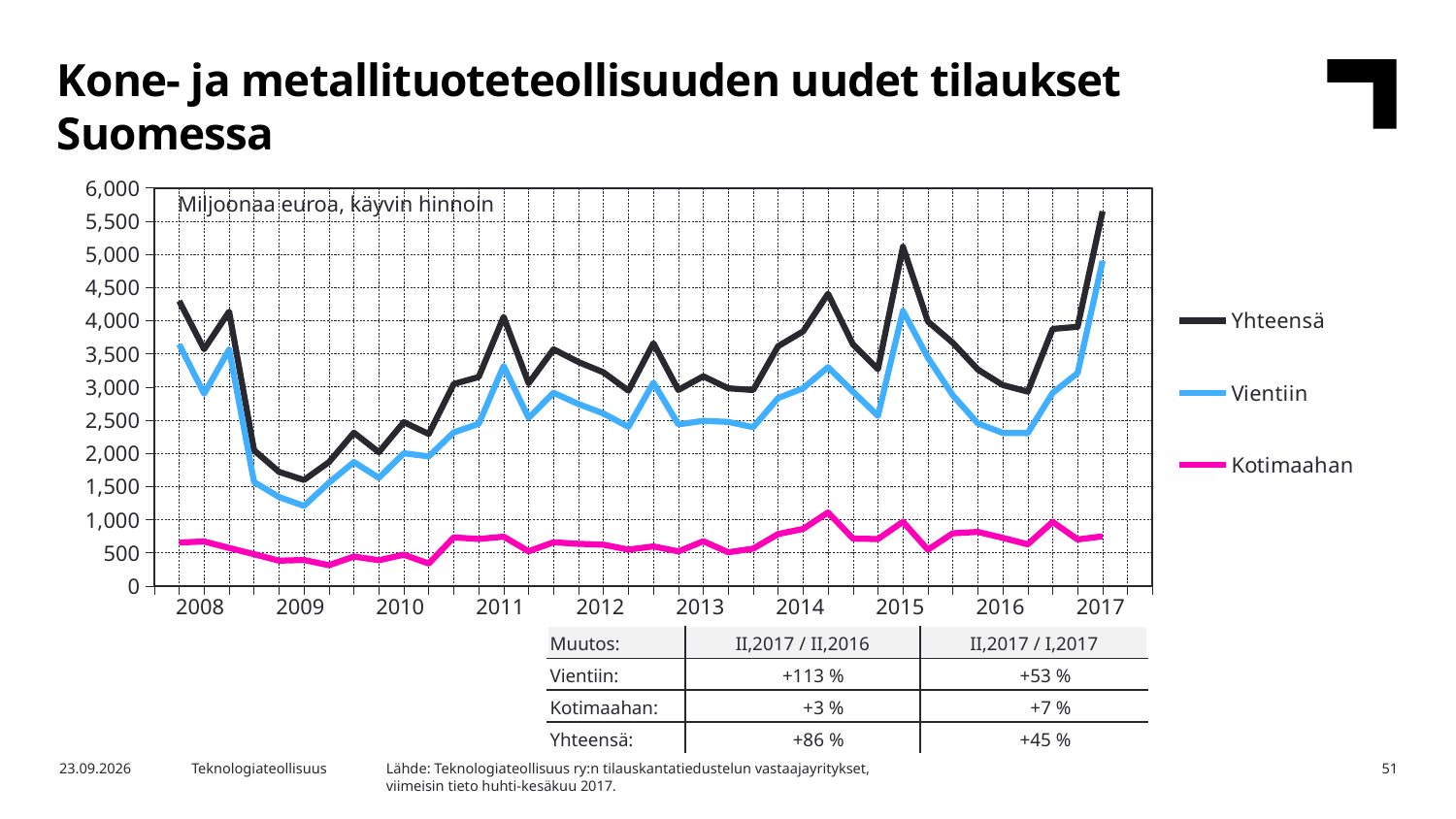
Does the Yhteensä line rise or fall from 2016 to 2017? rise Is the lowest value of Vientiin in 2009 greater or less than 1,500? less Is the value of Yhteensä at the last point in 2017 greater or less than 5,000? greater What are the three series named in the legend? Yhteensä, Vientiin, Kotimaahan According to the table below the chart, what is the change in Vientiin for II,2017 / II,2016? +113 % Which series has the highest values throughout the chart? Yhteensä Which series is larger in 2012, Vientiin or Kotimaahan? Vientiin How many series does the legend list? 3 Which series has the lowest values throughout the chart? Kotimaahan What unit is stated in the chart's label at the top of the plot area? Miljoonaa euroa, käyvin hinnoin Is the value of Kotimaahan at any point greater or less than 1,500? less What kind of chart is shown on the slide? line chart